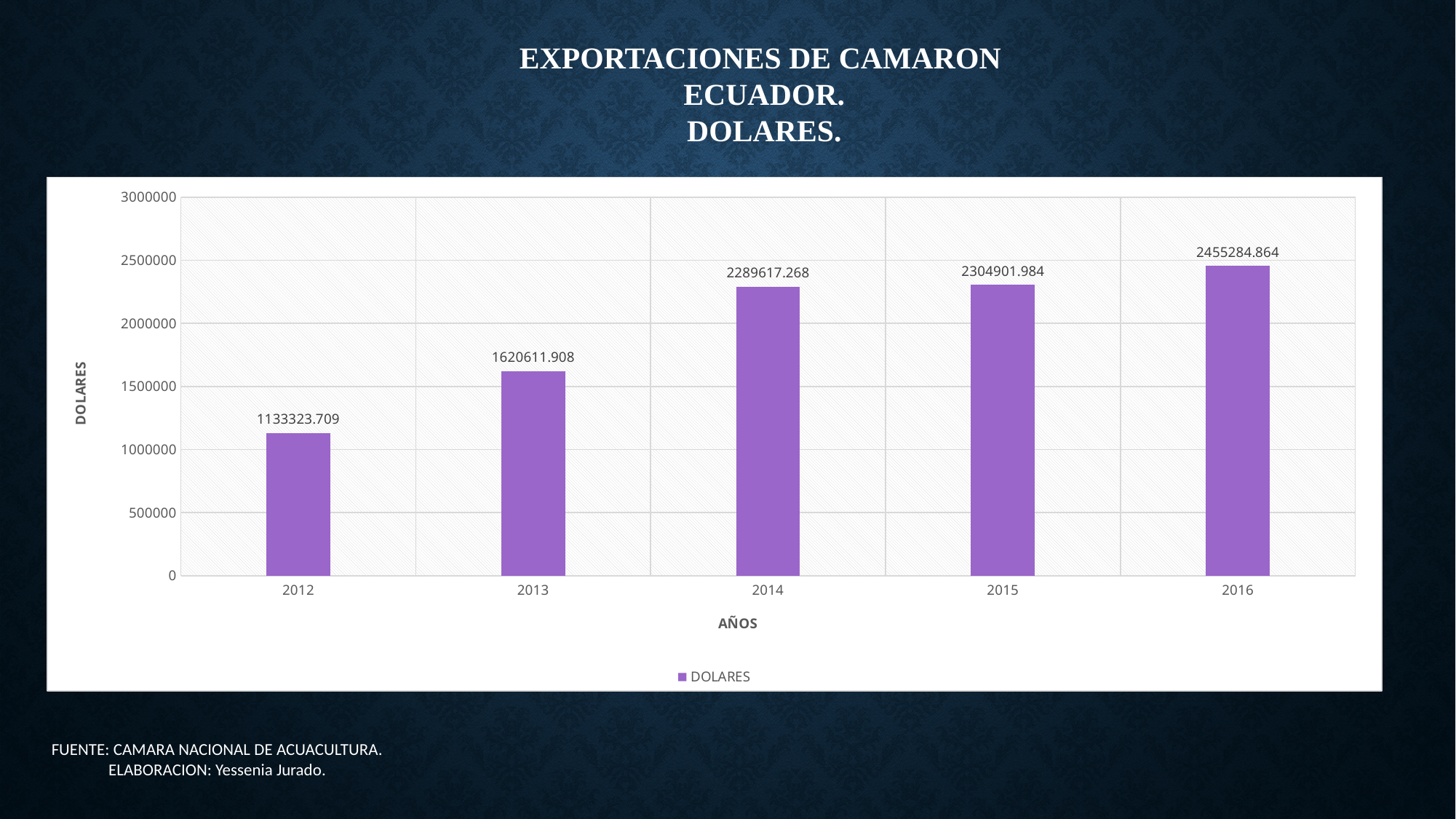
Which year has the lowest value? 2012 What is the value for 2012? 1133323.709 Is the value for 2013 greater or less than 1500000? greater How many years are shown on the x axis? 5 Which is larger, the value for 2013 or the value for 2014? 2014 What is the difference between the values for 2013 and 2012? 487288.199 What is the value for 2016? 2455284.864 What is the value for 2014? 2289617.268 Do the values rise or fall from 2012 to 2016? rise What kind of chart is shown? bar chart What is the difference between the values for 2016 and 2015? 150382.880 Which year has the highest value? 2016